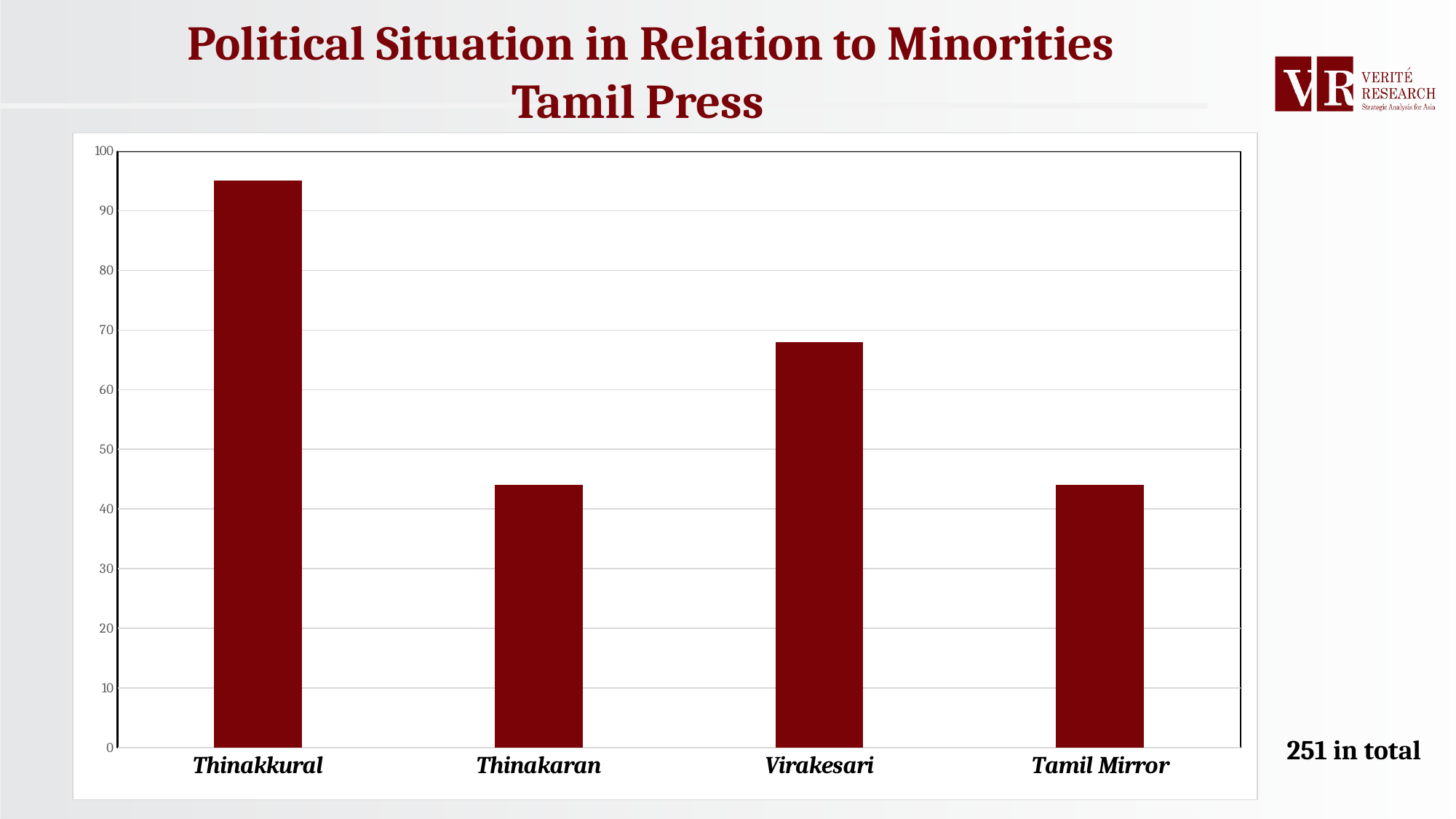
Is the value for Tamil Mirror greater or less than 40? greater Which is larger, the value for Virakesari or the value for Thinakaran? Virakesari Is the value for Thinakaran greater or less than 50? less Which is larger, the value for Thinakkural or the value for Virakesari? Thinakkural Is the value for Virakesari greater or less than 70? less What total is stated in the text to the right of the chart? 251 in total What kind of chart is shown on the slide? bar chart Which newspaper has the highest bar in the chart? Thinakkural What is the title of the slide containing the chart? Political Situation in Relation to Minorities Tamil Press How many newspapers (categories) are shown on the x axis of the chart? 4